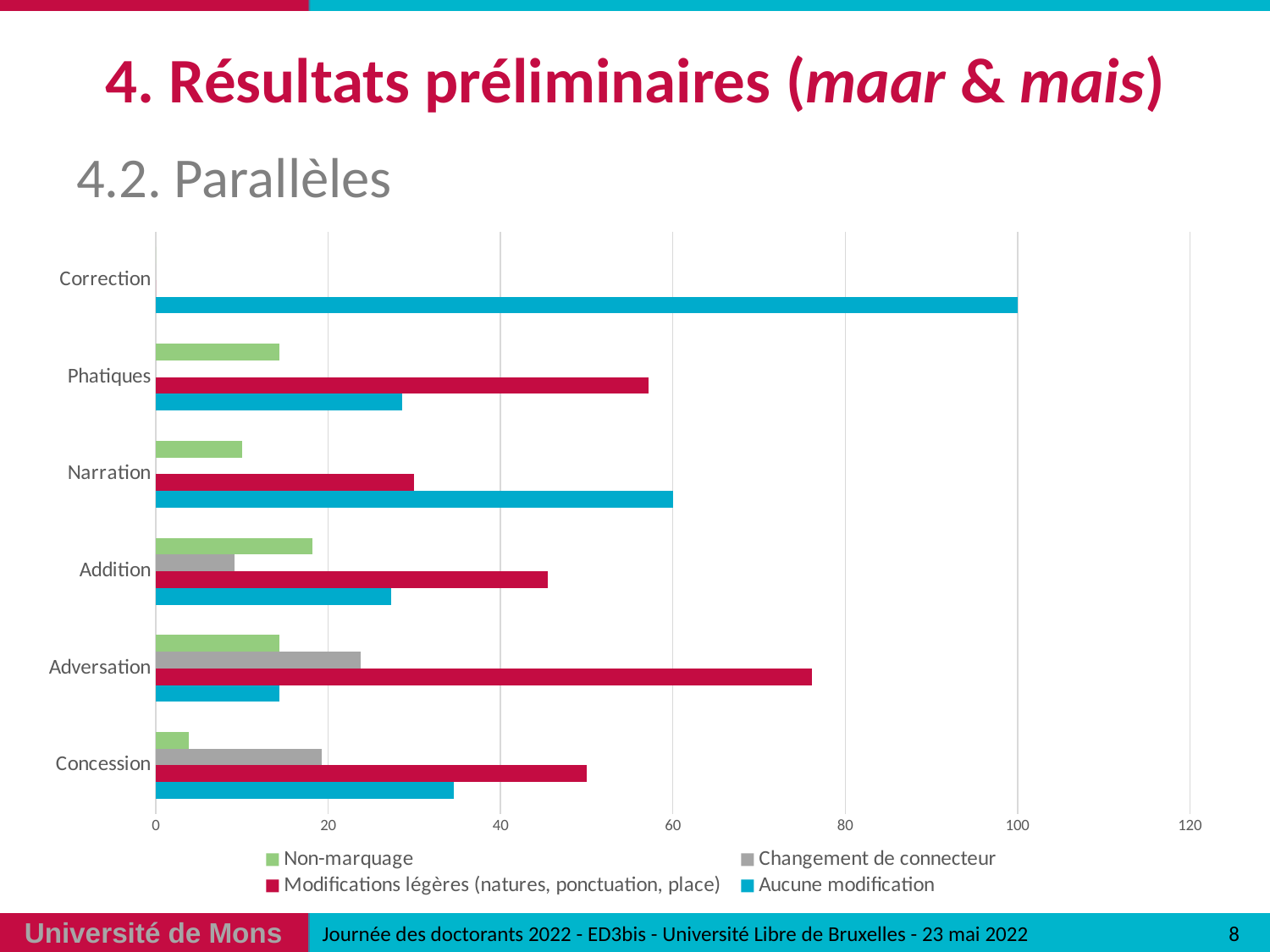
Which category has the highest value for Aucune modification? Correction How many categories are shown on the vertical axis of the chart? 6 Is the value of Modifications légères for Adversation greater or less than 60? greater What is the value of Aucune modification for Correction? 100 What kind of chart is shown on the slide? bar chart Is the value of Non-marquage for Narration greater or less than 20? less What is the value of Aucune modification for Narration? 60 How many series does the chart legend list? 4 For Adversation, which is larger: Modifications légères or Aucune modification? Modifications légères Which category has the lowest value for Non-marquage? Correction Which series is shown in blue in the chart legend? Aucune modification Is the value of Aucune modification for Concession greater or less than 40? less